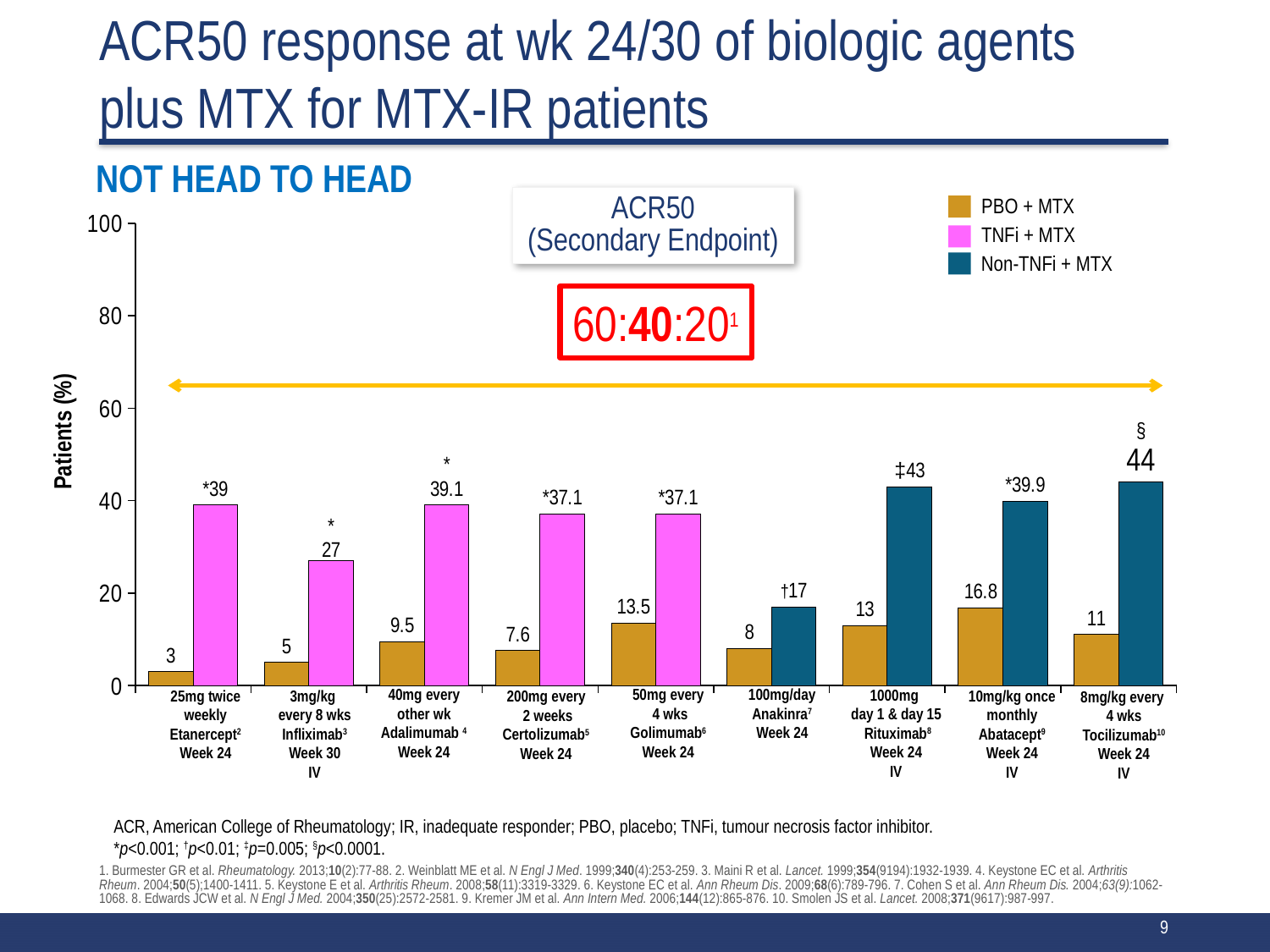
How many biologic agent groups are shown along the x axis? 9 Which drug group has the highest PBO + MTX ACR50 response? Abatacept What is the ACR50 response for PBO + MTX in the Etanercept (25mg twice weekly, Week 24) group? 3 What is the difference between the Adalimumab + MTX response (39.1) and its PBO + MTX response (9.5)? 29.6 What is the ACR50 response for Tocilizumab 8mg/kg every 4 wks plus MTX at Week 24? 44 Is the PBO + MTX ACR50 response larger in the Golimumab group or the Rituximab group? Golimumab What is the ACR50 response for PBO + MTX in the Abatacept group? 16.8 What is the ACR50 response for Adalimumab 40mg every other week plus MTX at Week 24? 39.1 How many series does the legend list? 3 Which biologic agent plus MTX has the highest ACR50 response on the chart? Tocilizumab What kind of chart is shown on the slide? Bar chart Which drug group has the lowest PBO + MTX ACR50 response? Etanercept